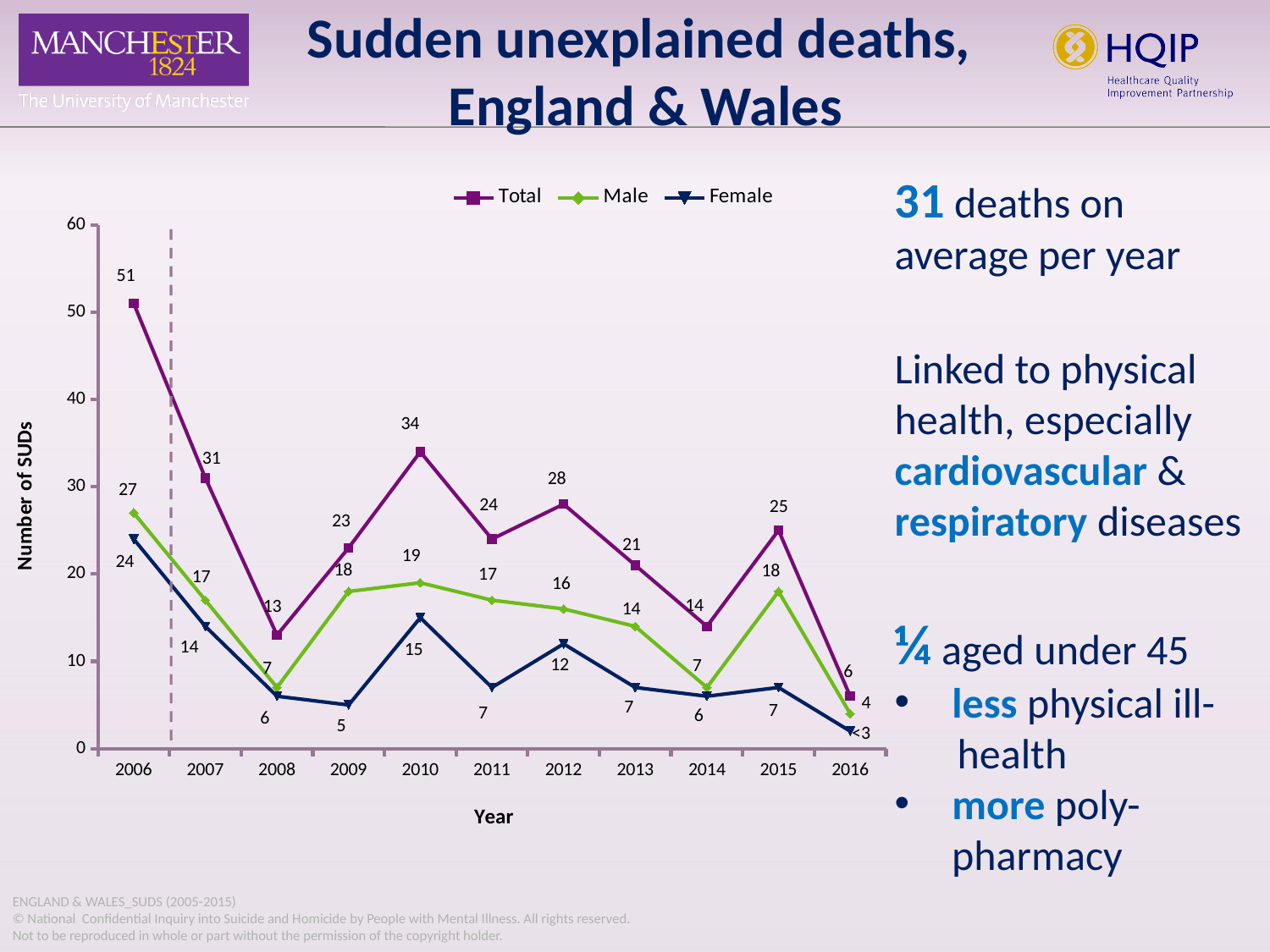
What is the Female value in 2012? 12 Does the Total line rise or fall from 2006 to 2008? fall How many series does the legend list? 3 What is the label of the y axis? Number of SUDs What is the Total number of SUDs in 2010? 34 What is the difference between the Total values in 2006 and 2007? 20 Which is larger in 2009, the Male value or the Female value? Male What type of chart is shown on the slide? line chart In which year is the Total number of SUDs highest? 2006 What is the Male value in 2015? 18 In which year is the Total number of SUDs lowest? 2016 How many years are plotted on the x axis? 11